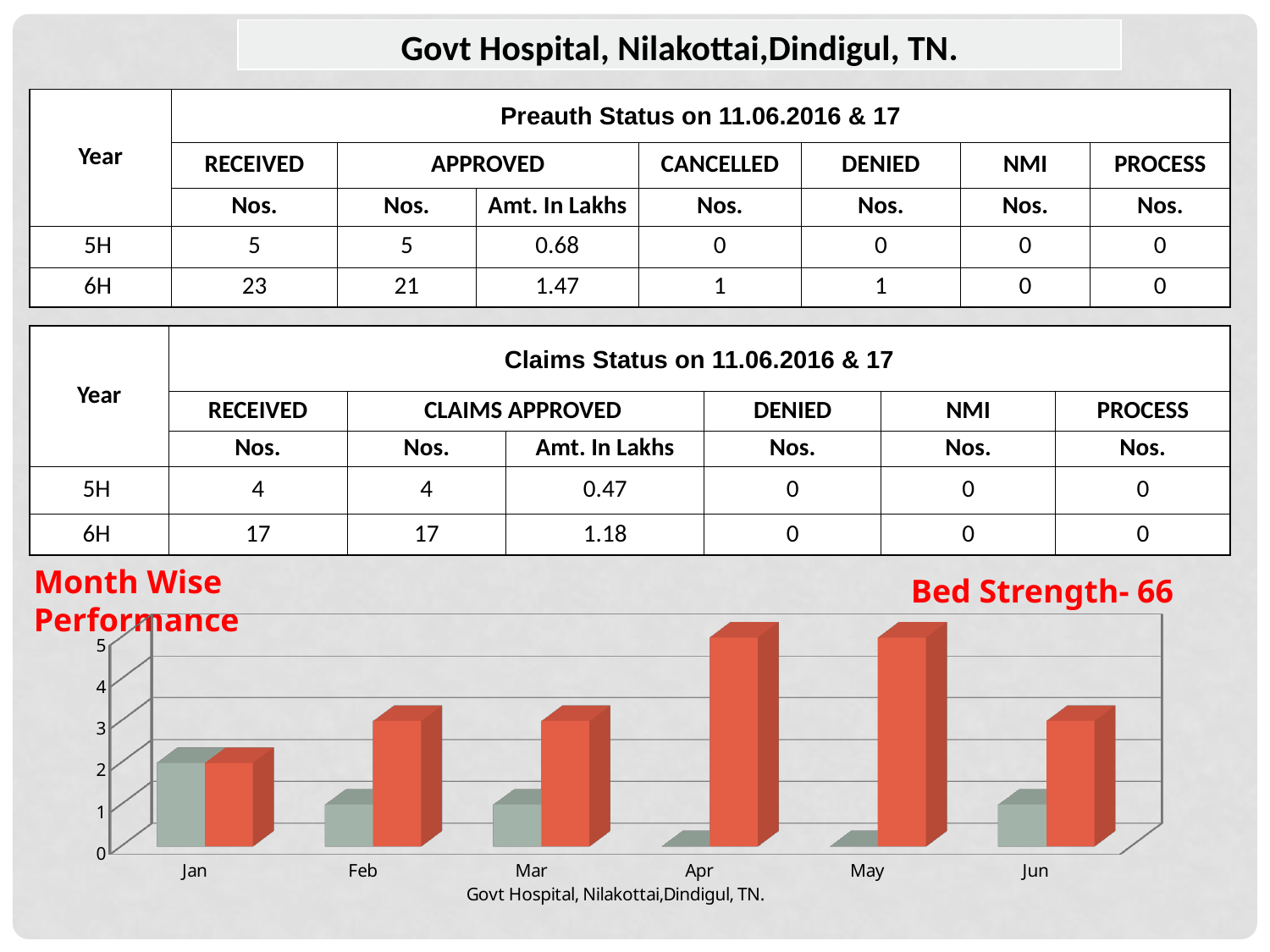
In the Month Wise Performance chart, which is taller: the orange bar for May or the orange bar for Jun? May How many months are shown on the x axis of the Month Wise Performance chart? 6 In the Month Wise Performance chart, which is taller: the orange bar for Feb or the orange bar for Jan? Feb What text appears below the month labels on the x axis of the Month Wise Performance chart? Govt Hospital, Nilakottai,Dindigul, TN. In the Month Wise Performance chart, is the orange bar for Apr greater or less than 4? greater In the Month Wise Performance chart, is the orange bar for Jun greater or less than 4? less In the Month Wise Performance chart, which month has the tallest grey bar? Jan In the Month Wise Performance chart, which month has the lowest orange bar? Jan In the Month Wise Performance chart, do the orange bars rise or fall from Jan to Apr? rise What is the highest value shown on the y axis of the Month Wise Performance chart? 5 What kind of chart is shown under the heading 'Month Wise Performance'? bar chart In the Month Wise Performance chart, is the grey bar for Feb greater or less than 2? less